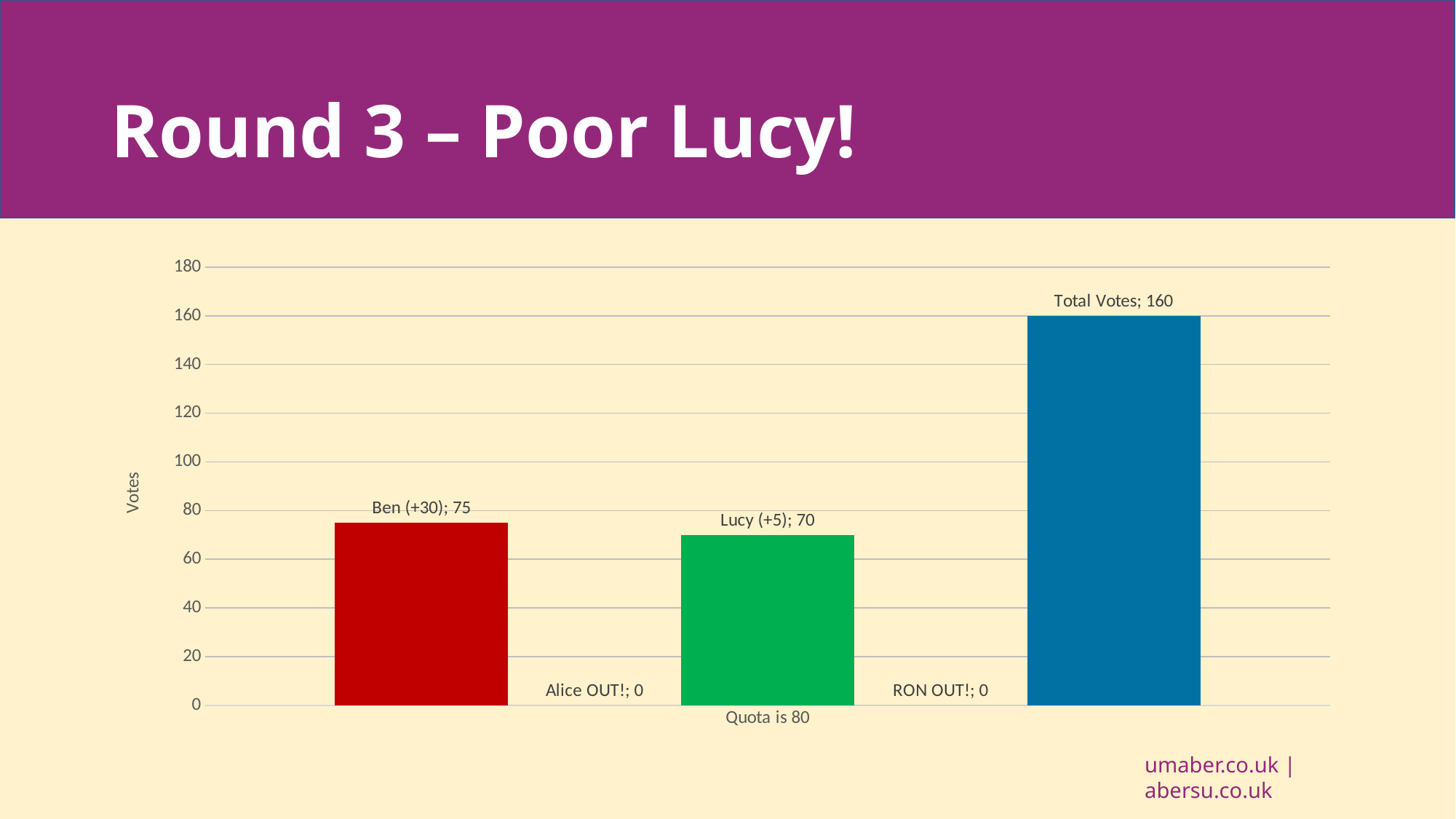
What is the value for Alice OUT!? 0 What is the value for Total Votes? 160 Which is larger, the value for Ben (+30) or the value for Lucy (+5)? Ben (+30) What is the label of the vertical axis? Votes Is the value for Lucy (+5) greater or less than 80? less What is the value for Ben (+30)? 75 What kind of chart is shown on the slide? bar chart Which category has the highest value? Total Votes What is the value for Lucy (+5)? 70 How many categories are shown on the x axis? 1 What is the difference between Total Votes and Ben (+30)? 85 What is the difference between Ben (+30) and Lucy (+5)? 5